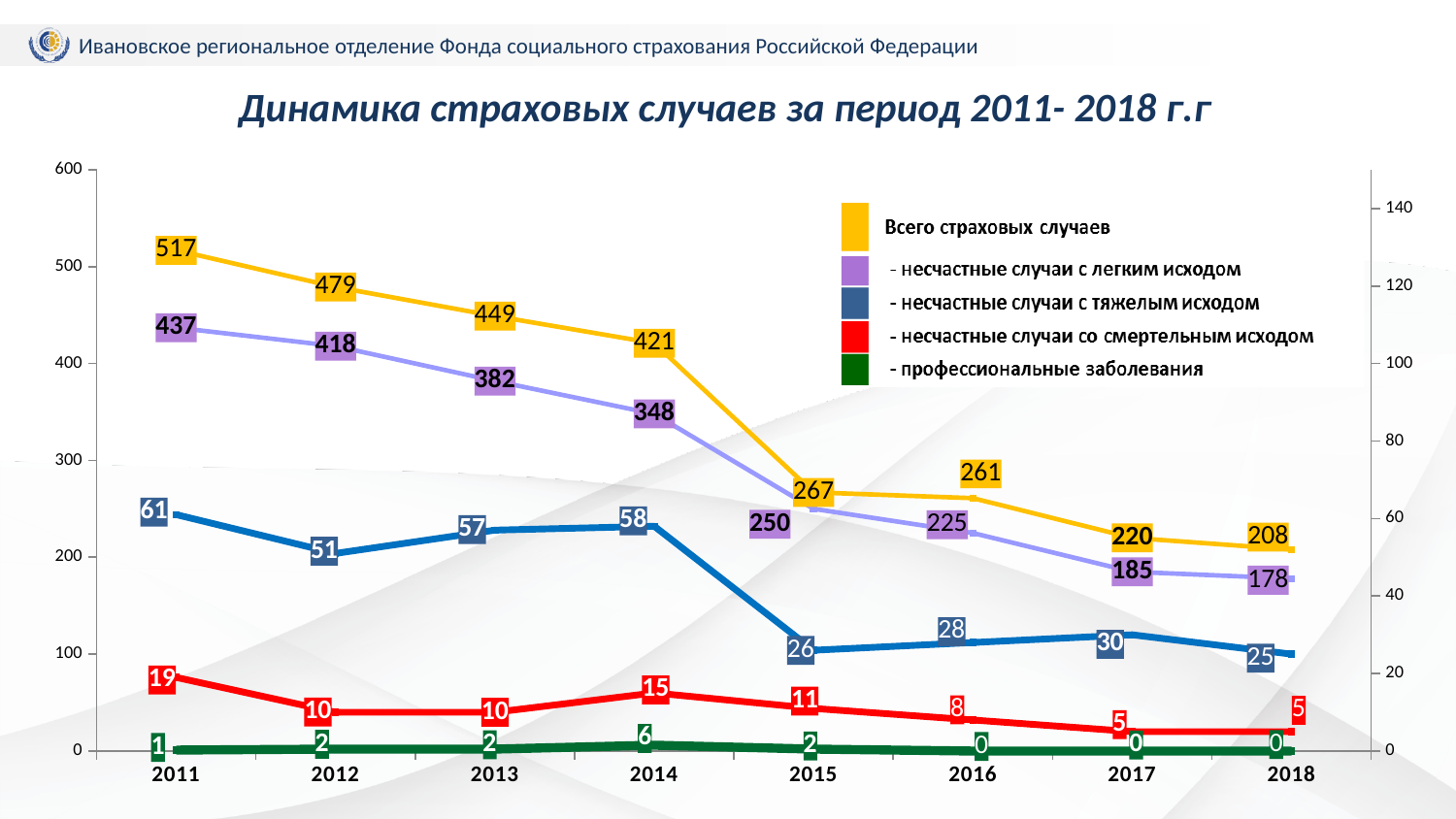
What is the value of 'несчастные случаи с легким исходом' in 2014? 348 What is the value of 'несчастные случаи со смертельным исходом' in 2011? 19 How many years are shown on the x axis? 8 What type of chart is shown on the slide? line chart In which year is 'профессиональные заболевания' highest? 2014 What is the difference between 'Всего страховых случаев' in 2011 and in 2018? 309 What is the value of 'Всего страховых случаев' in 2011? 517 Does 'Всего страховых случаев' rise or fall from 2011 to 2018? fall What is the value of 'несчастные случаи с тяжелым исходом' in 2017? 30 In which year is 'Всего страховых случаев' lowest? 2018 Which is larger: 'несчастные случаи с тяжелым исходом' in 2014 or in 2015? 2014 How many series does the legend list? 5